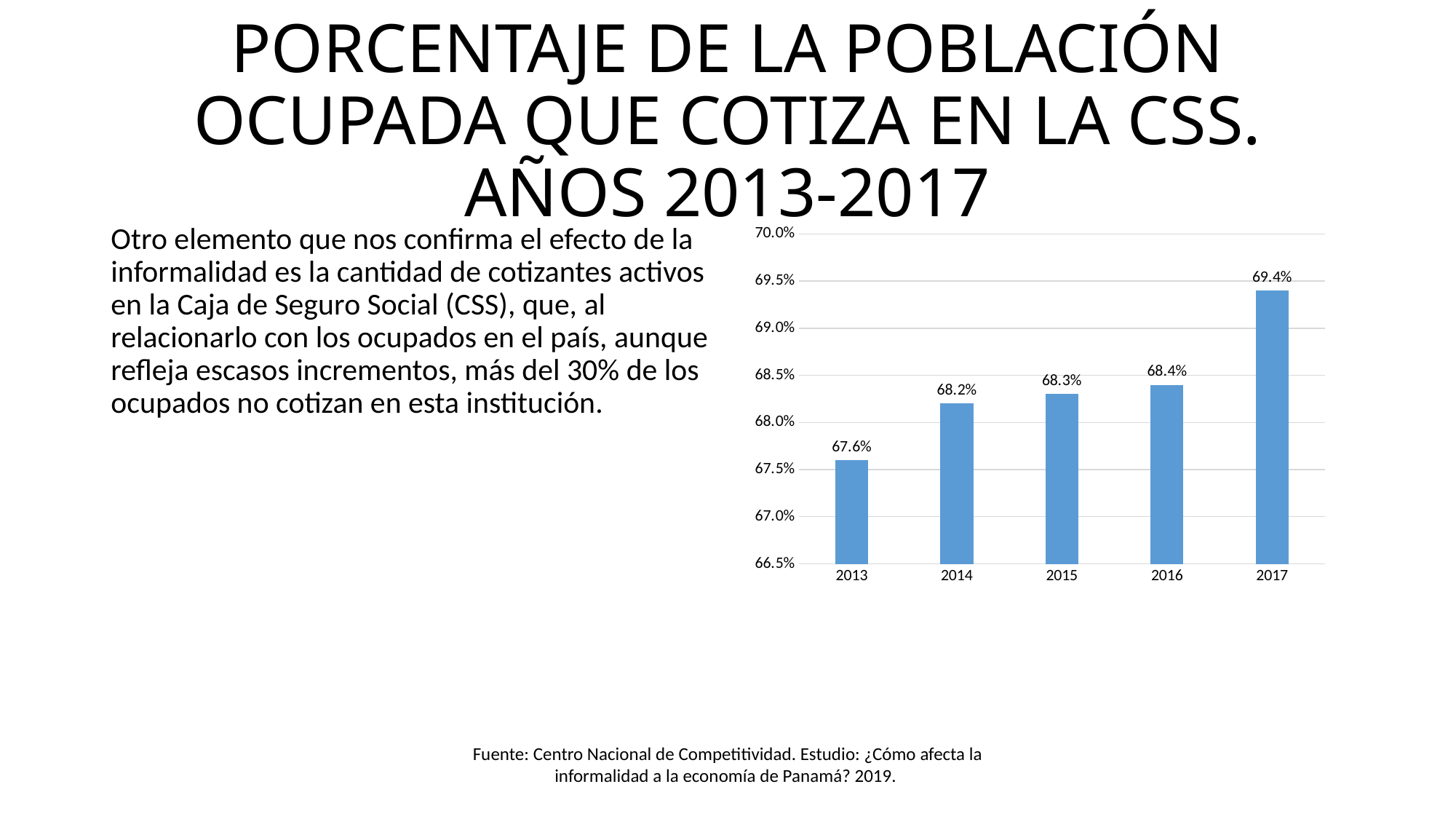
What kind of chart is shown on the slide? bar chart What is the value for 2013? 67.6% Which year has the lowest value? 2013 What is the value for 2017? 69.4% Do the values rise or fall from 2013 to 2017? rise How many years are shown on the x axis? 5 Which year has the highest value? 2017 What is the value for 2015? 68.3% Is the value for 2016 greater or less than 68.0%? greater What is the difference between the values for 2016 and 2014? 0.2% What is the difference between the values for 2017 and 2013? 1.8% Which is larger, the value for 2014 or the value for 2017? 2017